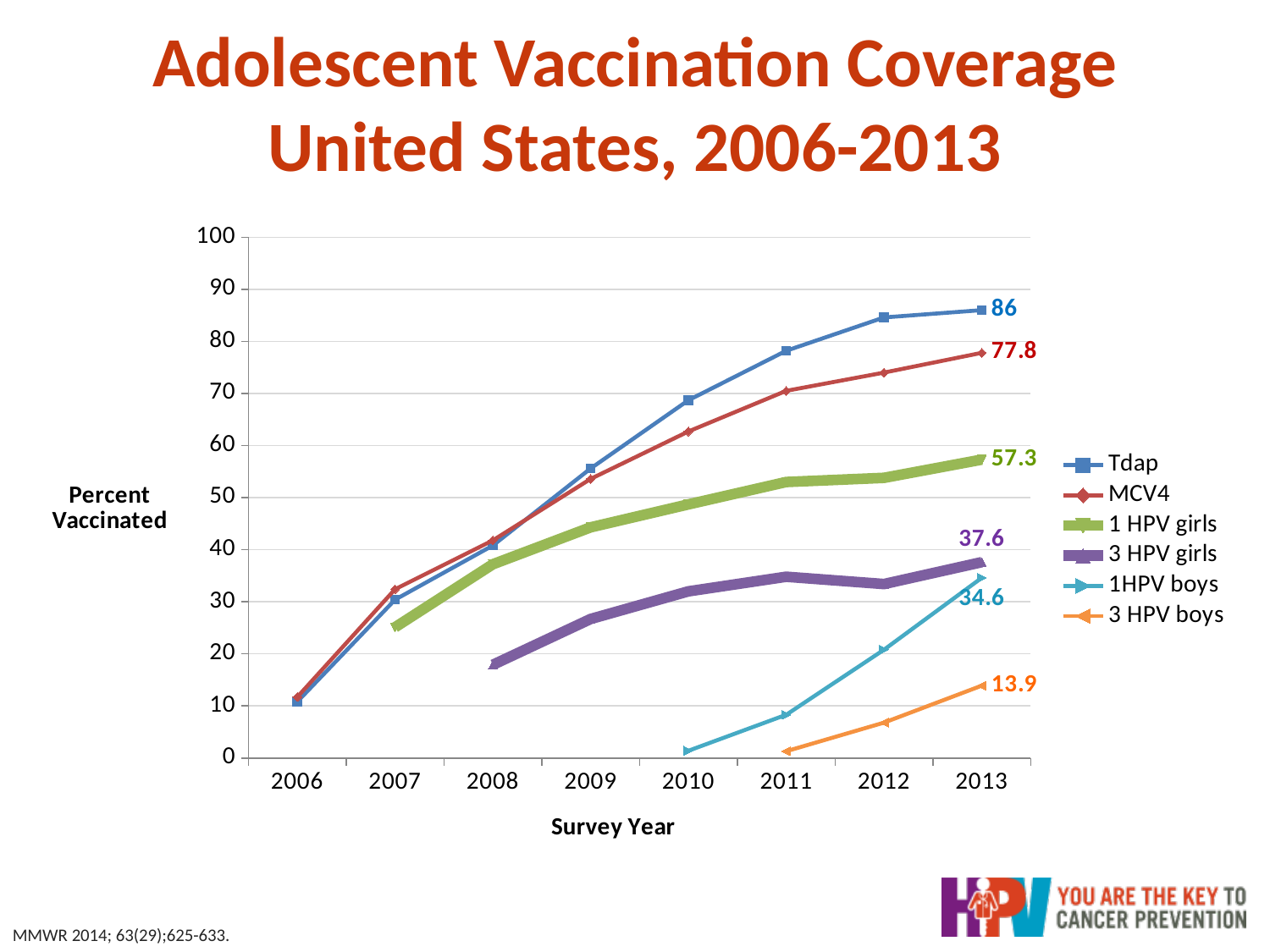
Does the 1 HPV girls series rise or fall from 2007 to 2013? Rise What is the 3 HPV boys coverage value shown for 2013? 13.9 How many series does the legend list? 6 What is the difference between the Tdap and MCV4 values in 2013? 8.2 Which series has the highest coverage in 2013? Tdap What is the Tdap coverage value shown for 2013? 86 Which series has the lowest coverage in 2013? 3 HPV boys In 2013, which is larger: 3 HPV girls or 1HPV boys? 3 HPV girls What kind of chart is shown on the slide? Line chart What is the MCV4 coverage value shown for 2013? 77.8 Is the Tdap value for 2010 greater or less than 60? greater What is the 1 HPV girls coverage value shown for 2013? 57.3